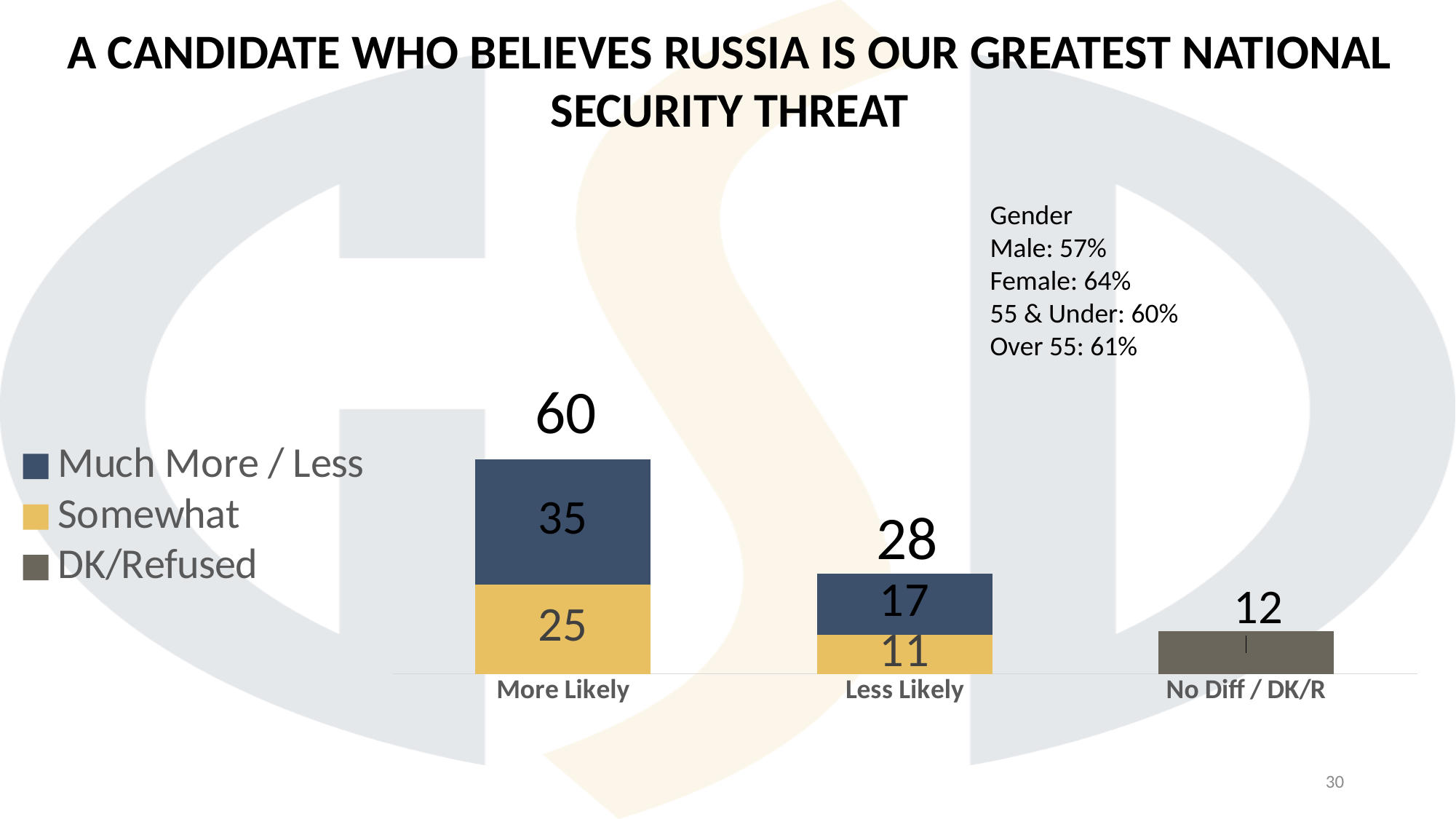
Which legend entry is shown in yellow? Somewhat Which category has the highest total? More Likely What is the Much More / Less value for Less Likely? 17 What is the difference between the totals for More Likely and Less Likely? 32 Which category has the lowest total? No Diff / DK/R How many categories are shown on the x axis? 3 What is the Somewhat value for More Likely? 25 What is the value for No Diff / DK/R? 12 Which is larger: the Somewhat value for More Likely or the Somewhat value for Less Likely? More Likely How many series does the legend list? 3 What is the total value of the More Likely bar? 60 What kind of chart is shown? Stacked bar chart